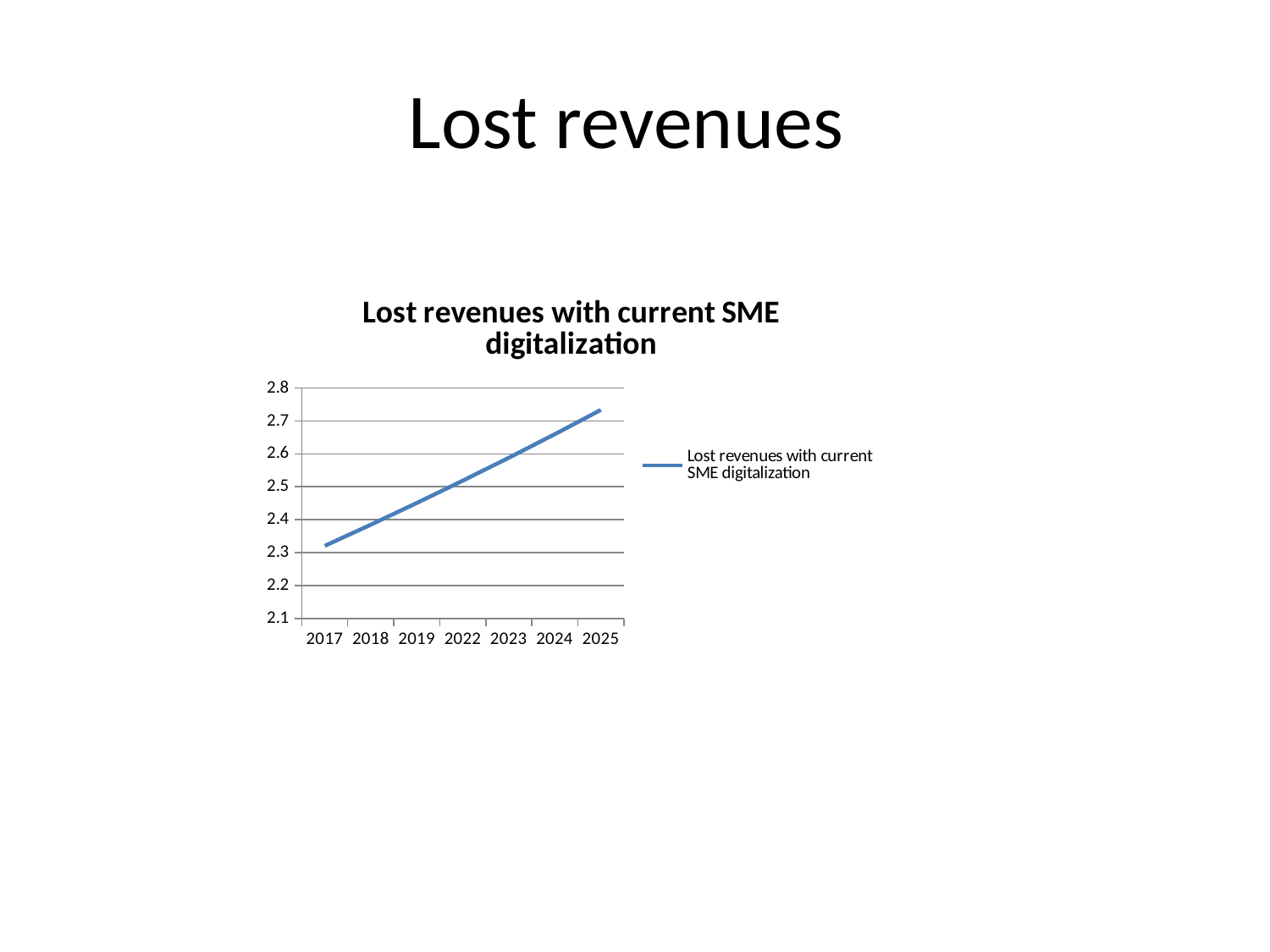
How many years are shown on the x axis? 7 Is the value for 2025 greater or less than 2.6? greater Which year has the highest value? 2025 Which year has the lowest value? 2017 Which is larger, the value for 2025 or the value for 2017? 2025 What is the title of the chart? Lost revenues with current SME digitalization Is the value for 2024 greater or less than 2.6? greater What kind of chart is shown on the slide? line chart Do the values rise or fall from 2017 to 2025? rise Is the value for 2019 greater or less than 2.5? less How many series does the legend list? 1